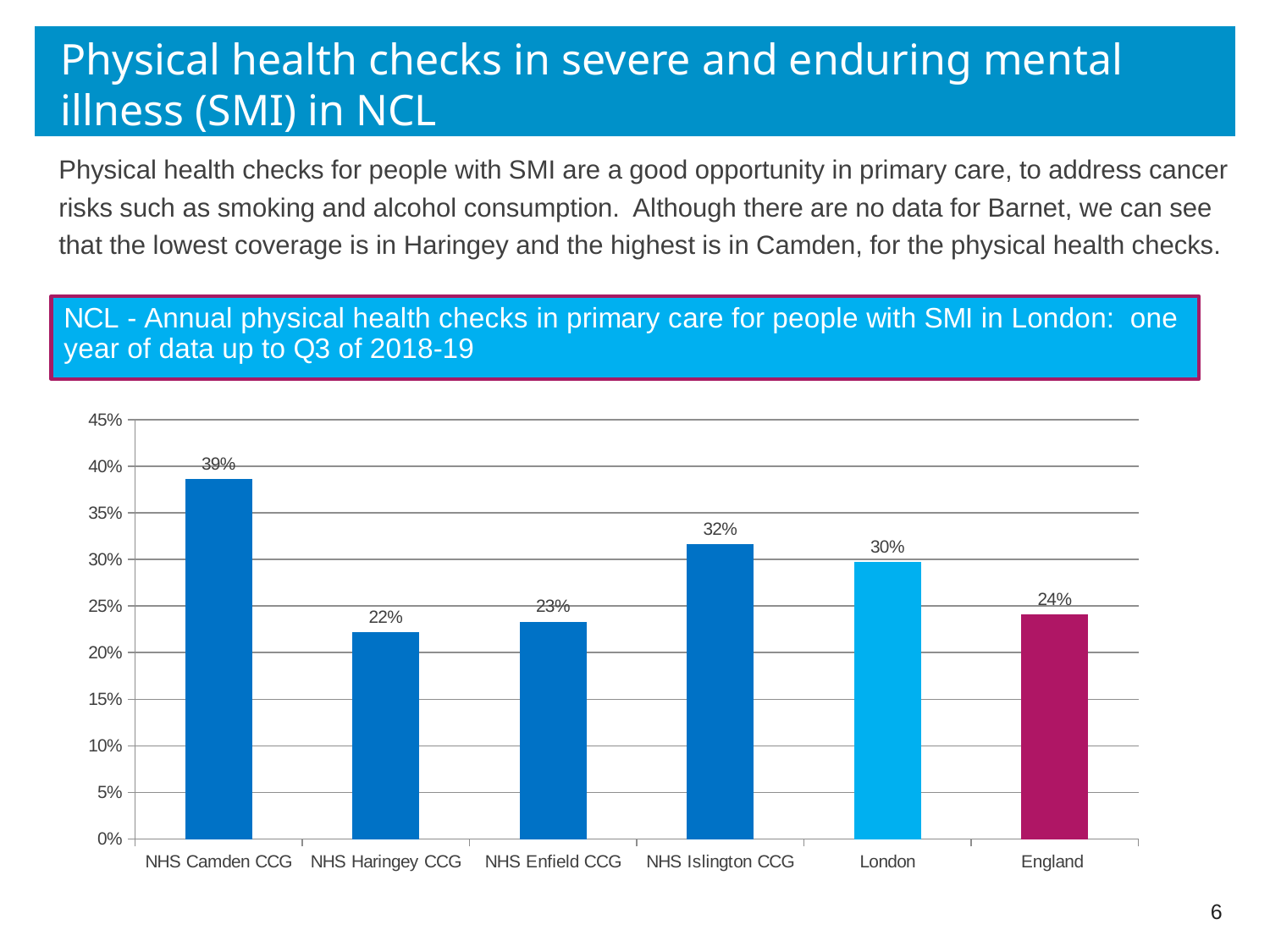
What is the difference between the values for NHS Islington CCG and England? 8% What kind of chart is shown on the slide? bar chart Which category has the lowest value? NHS Haringey CCG What is the difference between the values for NHS Camden CCG and NHS Haringey CCG? 17% What is the value for NHS Haringey CCG? 22% Is the value for NHS Enfield CCG greater or less than 25%? less What is the value for England? 24% Which category has the highest value? NHS Camden CCG Which is larger, the value for NHS Islington CCG or the value for London? NHS Islington CCG How many categories are shown on the x axis? 6 What is the value for London? 30% What is the value for NHS Camden CCG? 39%